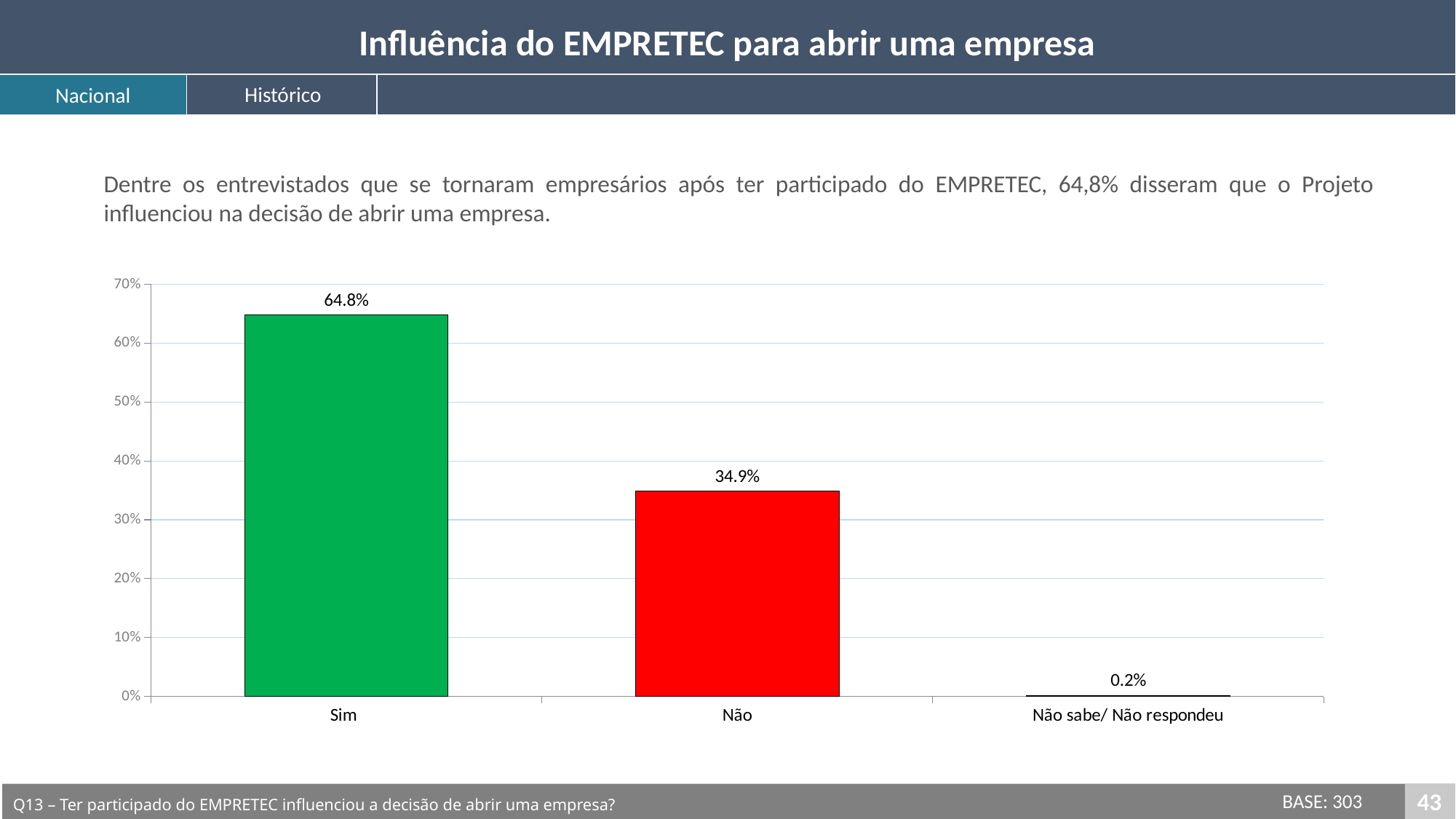
Which category has the highest value? Sim Which is larger, the value for Não or the value for Não sabe/ Não respondeu? Não What is the difference between the values for Sim and Não? 29.9% Do the values rise or fall from left to right along the x axis? fall What kind of chart is shown on the slide? bar chart What is the value for Sim? 64.8% Which category has the lowest value? Não sabe/ Não respondeu What is the value for Não sabe/ Não respondeu? 0.2% How many categories are shown on the x axis? 3 What colour is the bar for Não? red What is the value for Não? 34.9% Is the value for Sim greater or less than 60%? greater